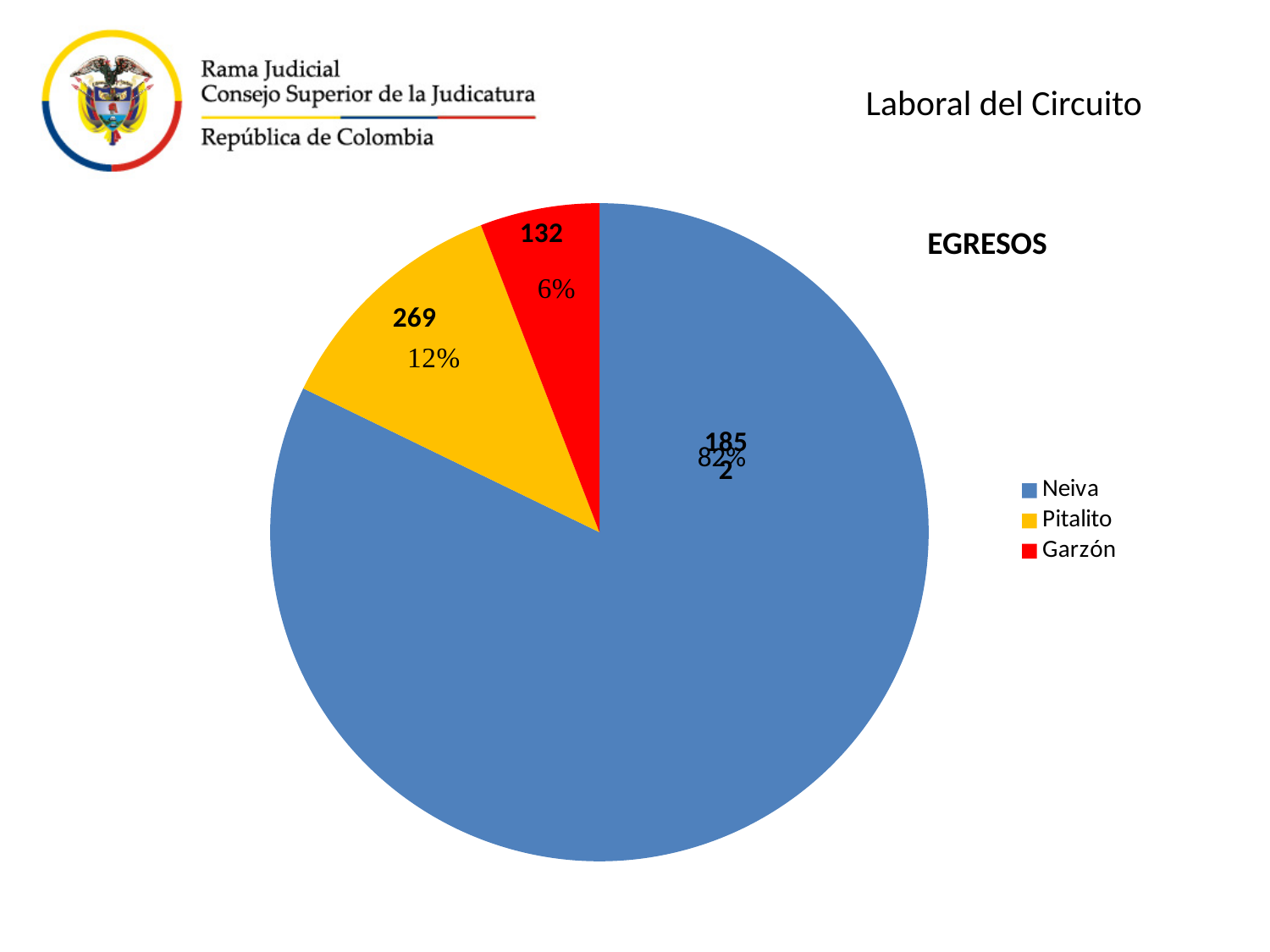
What is the value shown for Garzón? 132 What is the difference between the values for Pitalito and Garzón? 137 Which category has the largest slice of the pie? Neiva What share of the pie does Pitalito represent? 12% How many slices does the pie chart have? 3 What is the value shown for Pitalito? 269 Which colour represents Garzón in the pie chart? red What kind of chart is shown on the slide? pie chart How many entries does the legend list? 3 Which category has the smallest slice of the pie? Garzón What share of the pie does Garzón represent? 6% What is the title of the chart? EGRESOS